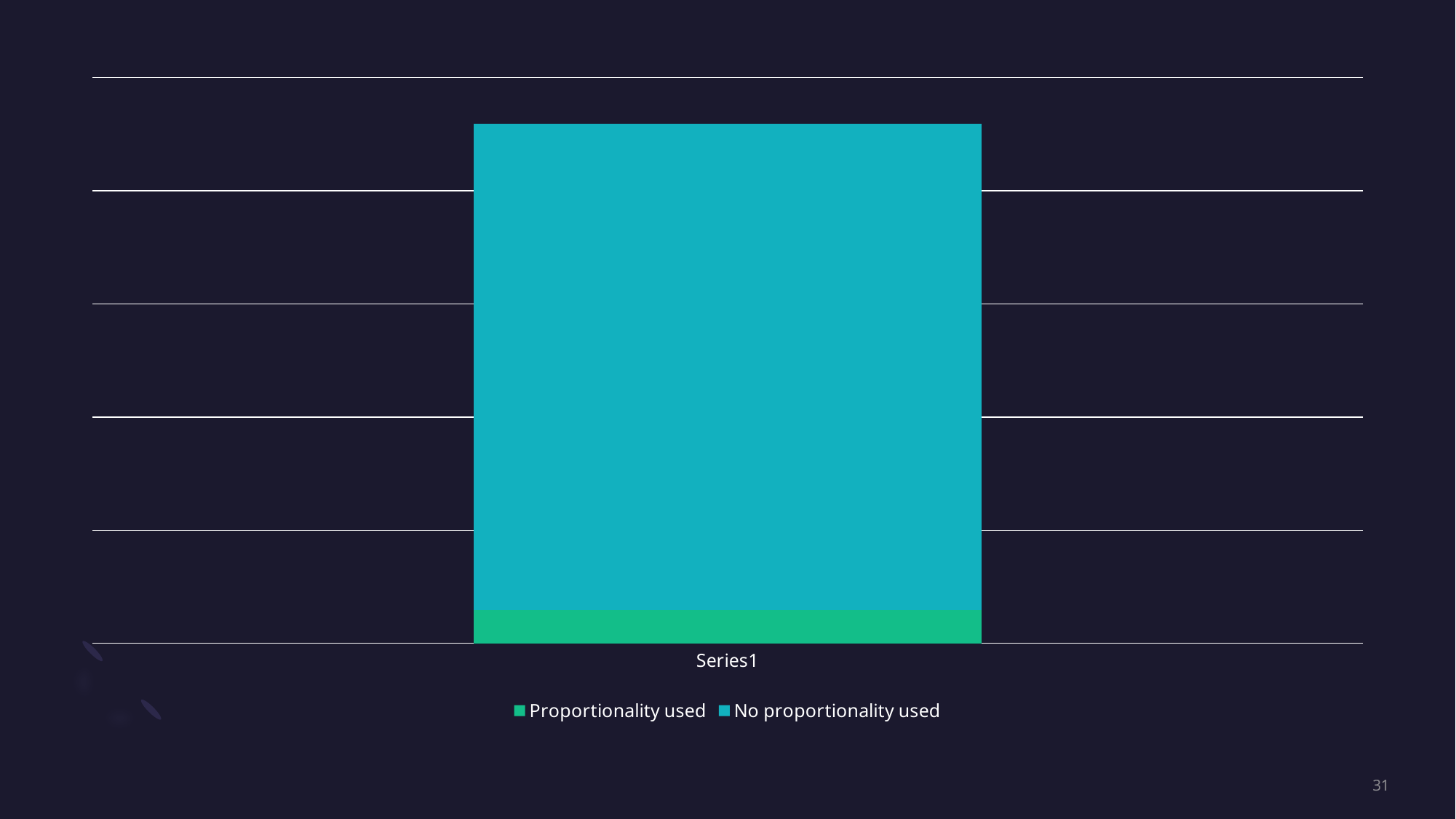
What is the label of the single category on the x axis? Series1 Which series takes up the larger part of the bar, Proportionality used or No proportionality used? No proportionality used What colour is the segment for No proportionality used? Teal Which series has the largest segment in the stacked bar? No proportionality used Which series has the smallest segment in the stacked bar? Proportionality used How many categories are shown on the x axis? 1 What kind of chart is shown on the slide? Stacked bar chart How many series does the legend list? 2